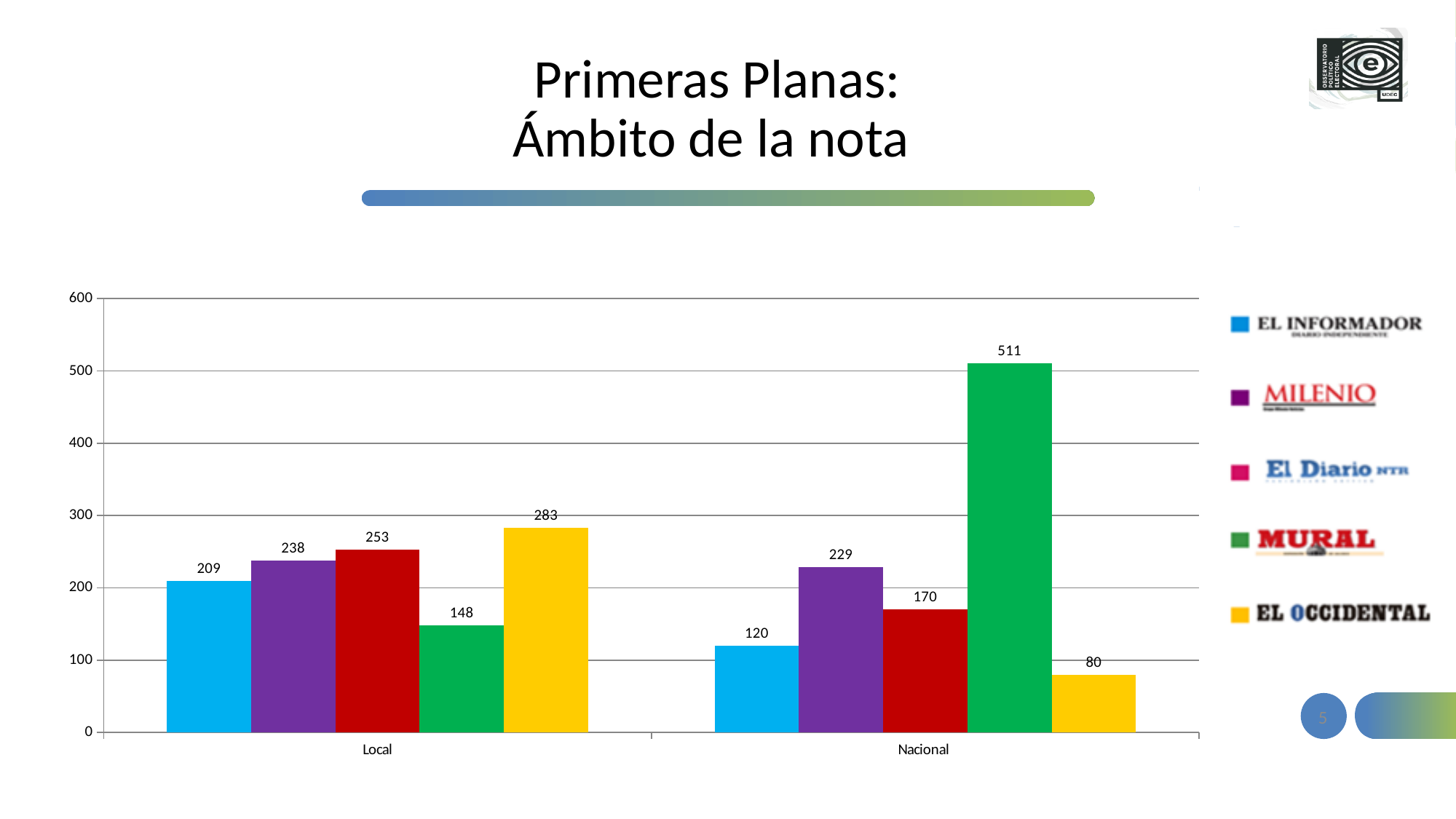
Is the value for Mural in the Nacional category greater or less than 500? greater How many series does the legend list? 5 What is the value for El Informador in the Local category? 209 What is the value for El Occidental in the Nacional category? 80 What is the value for Mural in the Nacional category? 511 Which is larger: Milenio's Local value or El Diario NTR's Local value? El Diario NTR's Local value What is the title of the slide? Primeras Planas: Ámbito de la nota What kind of chart is shown on the slide? Bar chart What is the difference between El Occidental's Local value and its Nacional value? 203 Which newspaper has the highest value in the Nacional category? Mural How many categories are shown on the x axis? 2 Which newspaper has the lowest value in the Local category? Mural